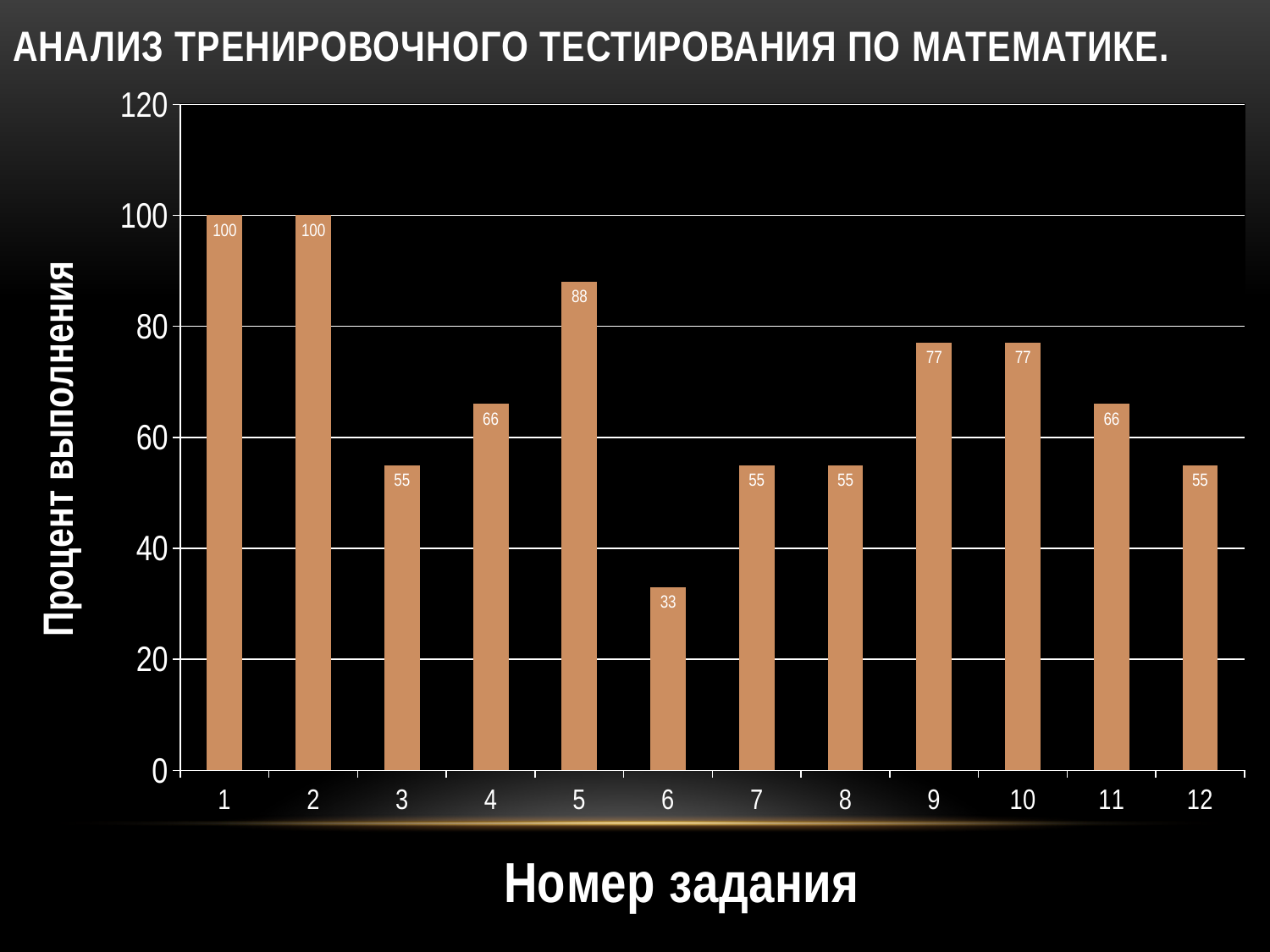
What is the completion percentage for task 5? 88 What is the difference between the values for task 9 and task 12? 22 What is the difference between the values for task 1 and task 6? 67 How many tasks have a value of 55? 4 Is the value for task 10 greater or less than 60? greater What is the value shown for task 11? 66 How many tasks are shown on the x axis? 12 Which is larger, the value for task 4 or the value for task 5? task 5 What is the value shown for task 6? 33 Which task has the lowest completion percentage? 6 What is the label of the y axis? Процент выполнения What kind of chart is shown on the slide? bar chart